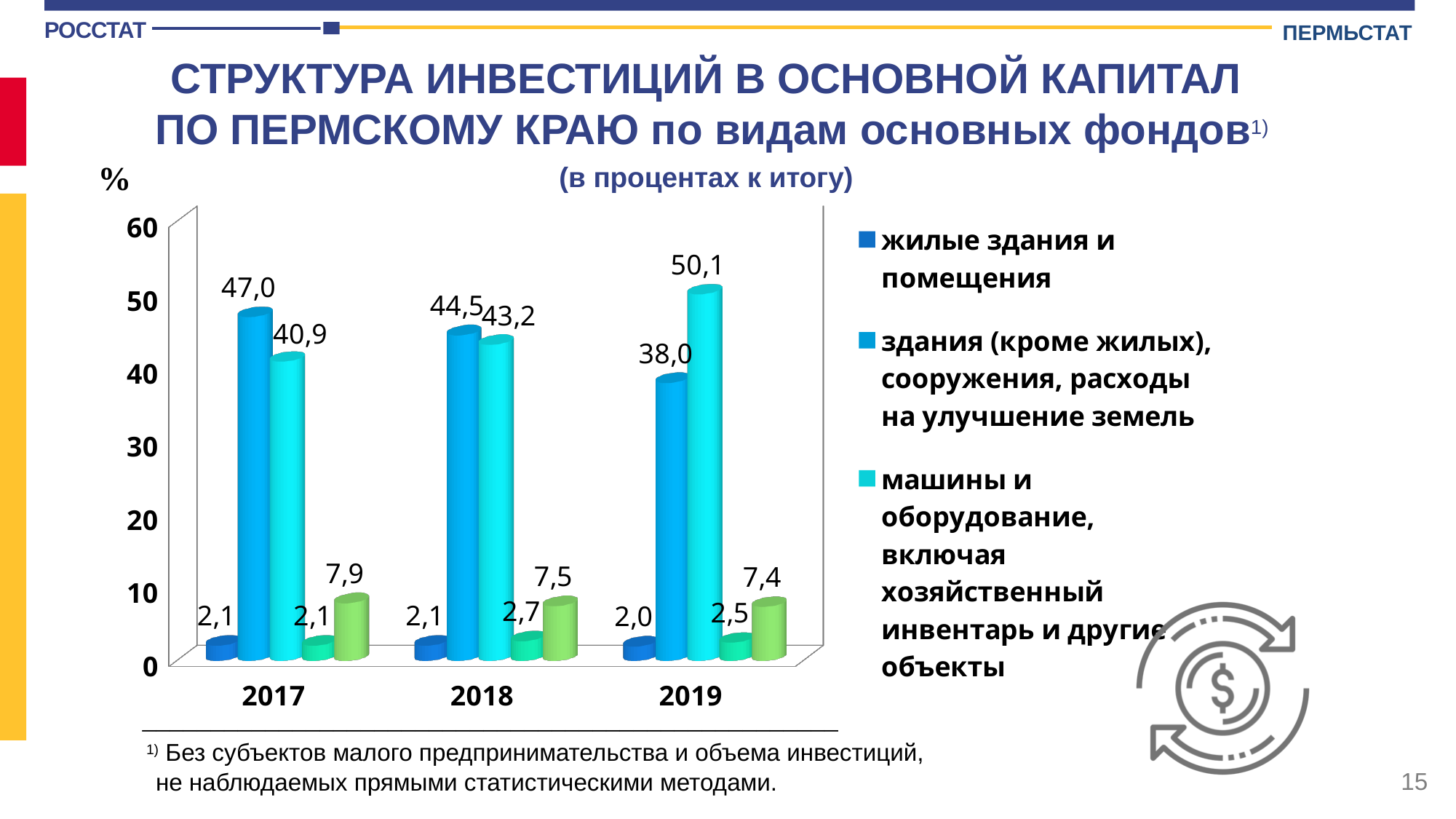
What kind of chart is shown on the slide? bar chart What is the value for жилые здания и помещения in 2019? 2,0 What is the value for машины и оборудование in 2019? 50,1 Which is larger in 2019: здания (кроме жилых) or машины и оборудование? машины и оборудование Does the value for машины и оборудование rise or fall from 2017 to 2019? rise How many years are shown on the x axis? 3 What is the difference between the value for здания (кроме жилых) in 2017 and in 2019? 9,0 What is the value for машины и оборудование in 2018? 43,2 What unit is shown on the vertical axis of the chart? % What is the value for здания (кроме жилых), сооружения, расходы на улучшение земель in 2017? 47,0 In which year is the value for машины и оборудование the highest? 2019 In which year is the value for здания (кроме жилых), сооружения, расходы на улучшение земель the lowest? 2019